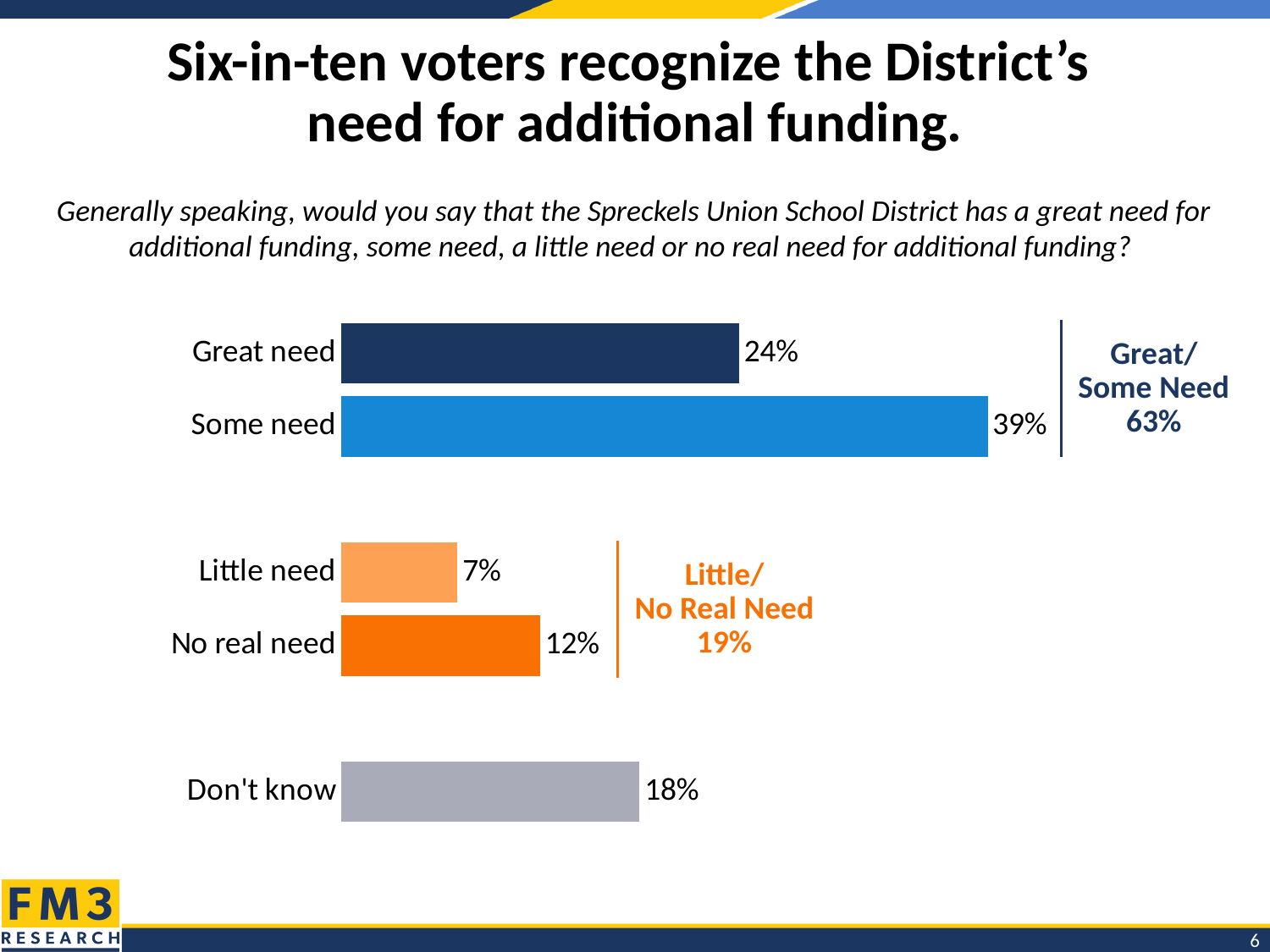
Which response category has the lowest percentage? Little need What percentage of voters said the District has a great need for additional funding? 24% Which is larger, the percentage for 'No real need' or for 'Don't know'? Don't know What percentage of voters answered 'Don't know'? 18% What is the combined percentage for 'Great need' and 'Some need' shown on the slide? 63% How many response categories are shown in the chart? 5 Which response category has the highest percentage? Some need What percentage of voters said the District has some need for additional funding? 39% What is the combined percentage for 'Little need' and 'No real need' shown on the slide? 19% What percentage of voters said the District has little need for additional funding? 7% What is the difference in percentage points between 'Some need' and 'Great need'? 15 What type of chart is shown on the slide? Bar chart